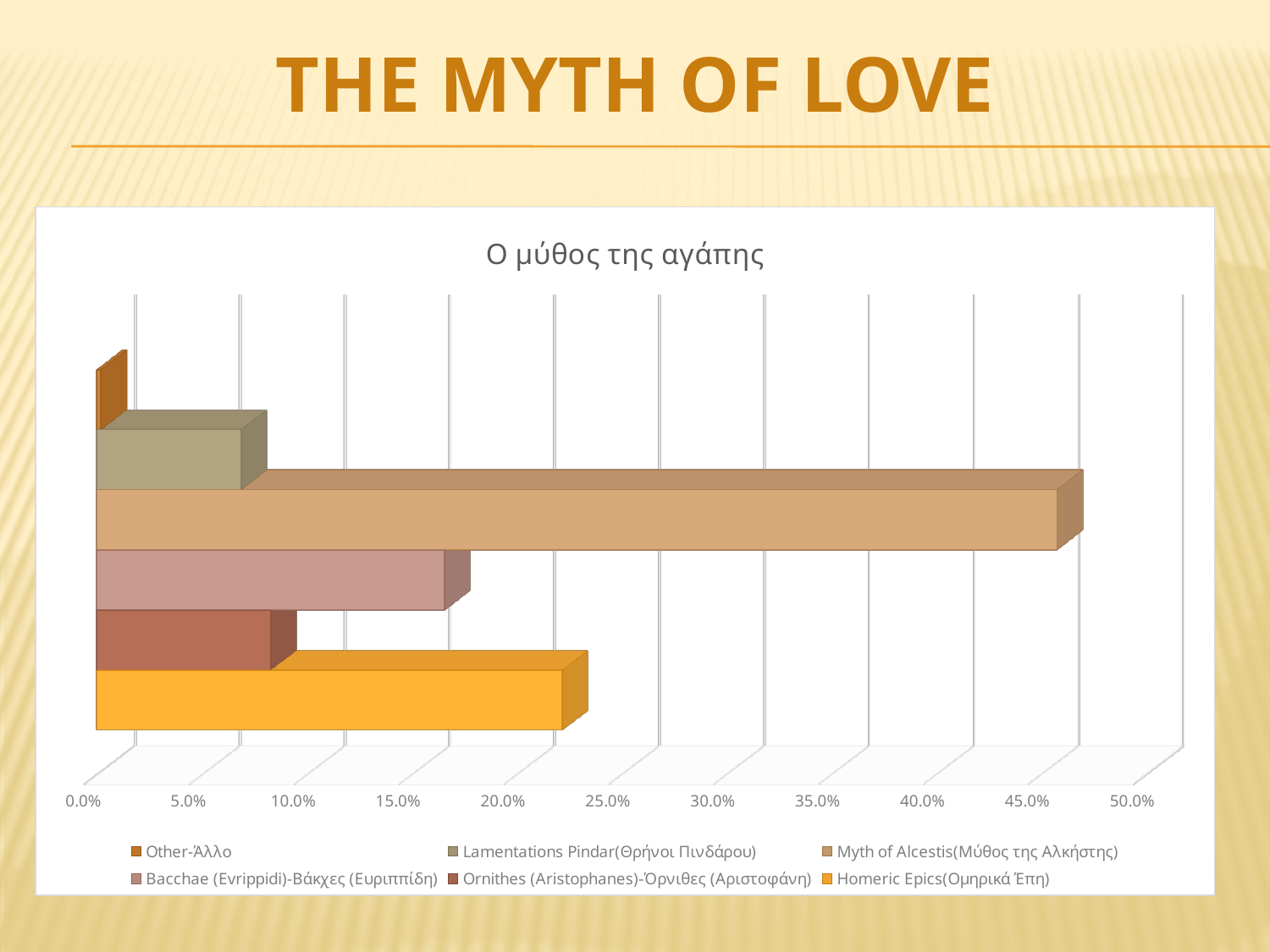
Is the value for Bacchae (Evrippidi)-Βάκχες (Ευριππίδη) greater or less than 20.0%? less What kind of chart is shown on the slide? bar chart Which is larger, the value for Homeric Epics(Ομηρικά Έπη) or the value for Bacchae (Evrippidi)-Βάκχες (Ευριππίδη)? Homeric Epics(Ομηρικά Έπη) Which series has the lowest value in the chart? Other-Άλλο Which is larger, the value for Bacchae (Evrippidi)-Βάκχες (Ευριππίδη) or the value for Ornithes (Aristophanes)-Όρνιθες (Αριστοφάνη)? Bacchae (Evrippidi)-Βάκχες (Ευριππίδη) Is the value for Other-Άλλο greater or less than 5.0%? less What is the title of the chart? Ο μύθος της αγάπης Is the value for Myth of Alcestis(Μύθος της Αλκήστης) greater or less than 40.0%? greater How many series does the chart legend list? 6 Which series has the highest value in the chart? Myth of Alcestis(Μύθος της Αλκήστης)